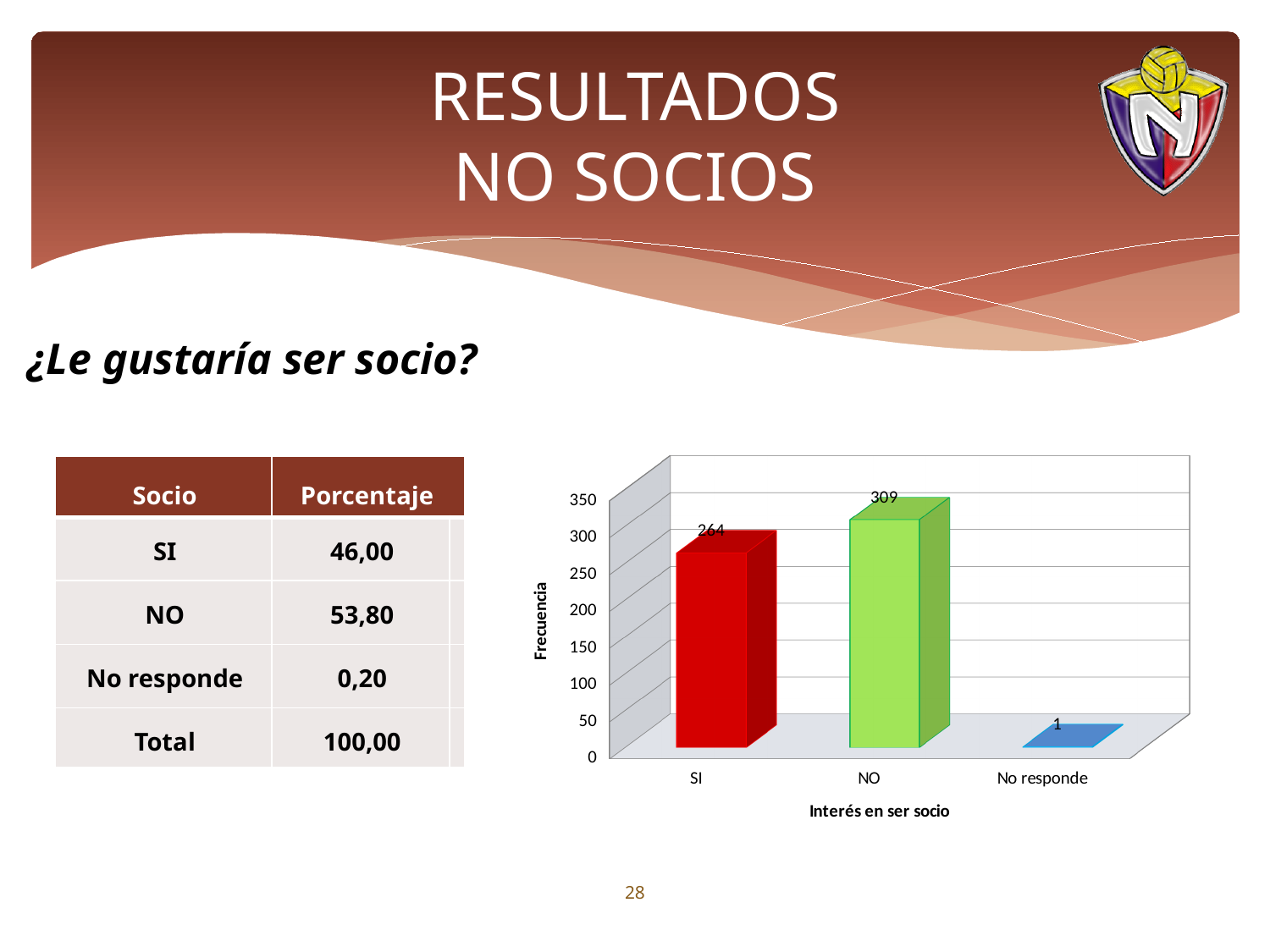
What kind of chart is shown on the slide? bar chart Which category has the highest value in the chart? NO What is the label of the horizontal axis of the chart? Interés en ser socio What is the label of the vertical axis of the chart? Frecuencia What is the value for NO in the chart? 309 What is the value for SI in the chart? 264 What is the difference between the values for NO and SI? 45 Which category has the lowest value in the chart? No responde What is the value for No responde in the chart? 1 How many categories are shown on the x axis of the chart? 3 Which is larger, the value for SI or the value for NO? NO Is the value for SI greater or less than 250? greater